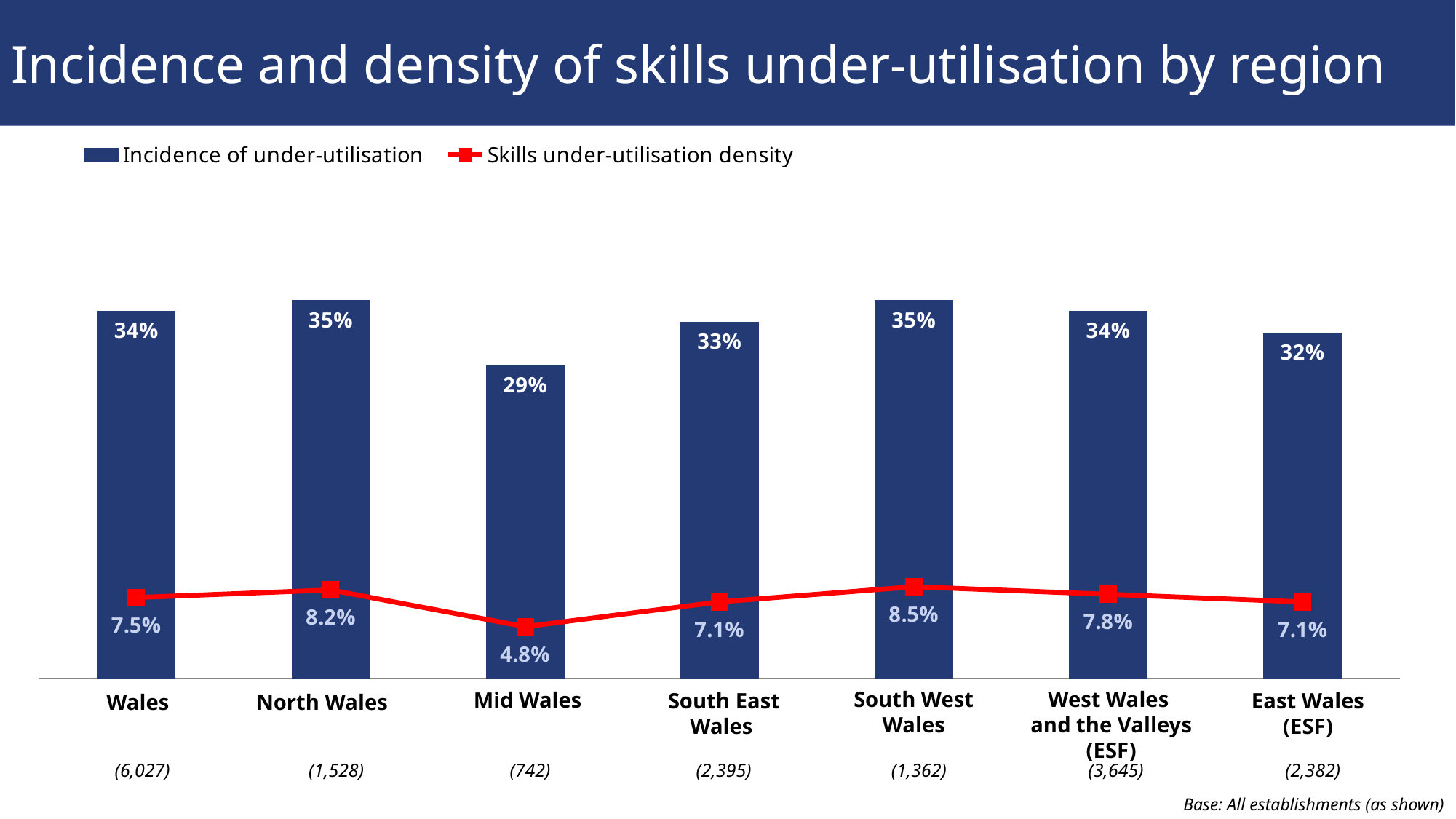
How many regions are shown on the x axis? 7 Which region has the highest skills under-utilisation density? South West Wales What is the incidence of under-utilisation for Mid Wales? 29% How many series does the legend list? 2 What is the difference in incidence of under-utilisation between South West Wales and East Wales (ESF)? 3 percentage points What is the base (number of establishments) shown for West Wales and the Valleys (ESF)? 3,645 Which region has the lowest incidence of under-utilisation? Mid Wales What is the skills under-utilisation density for South West Wales? 8.5% What is the skills under-utilisation density for Wales overall? 7.5% Which has a higher incidence of under-utilisation, South East Wales or East Wales (ESF)? South East Wales Which region has the lowest skills under-utilisation density? Mid Wales What is the difference in skills under-utilisation density between North Wales and Mid Wales? 3.4 percentage points